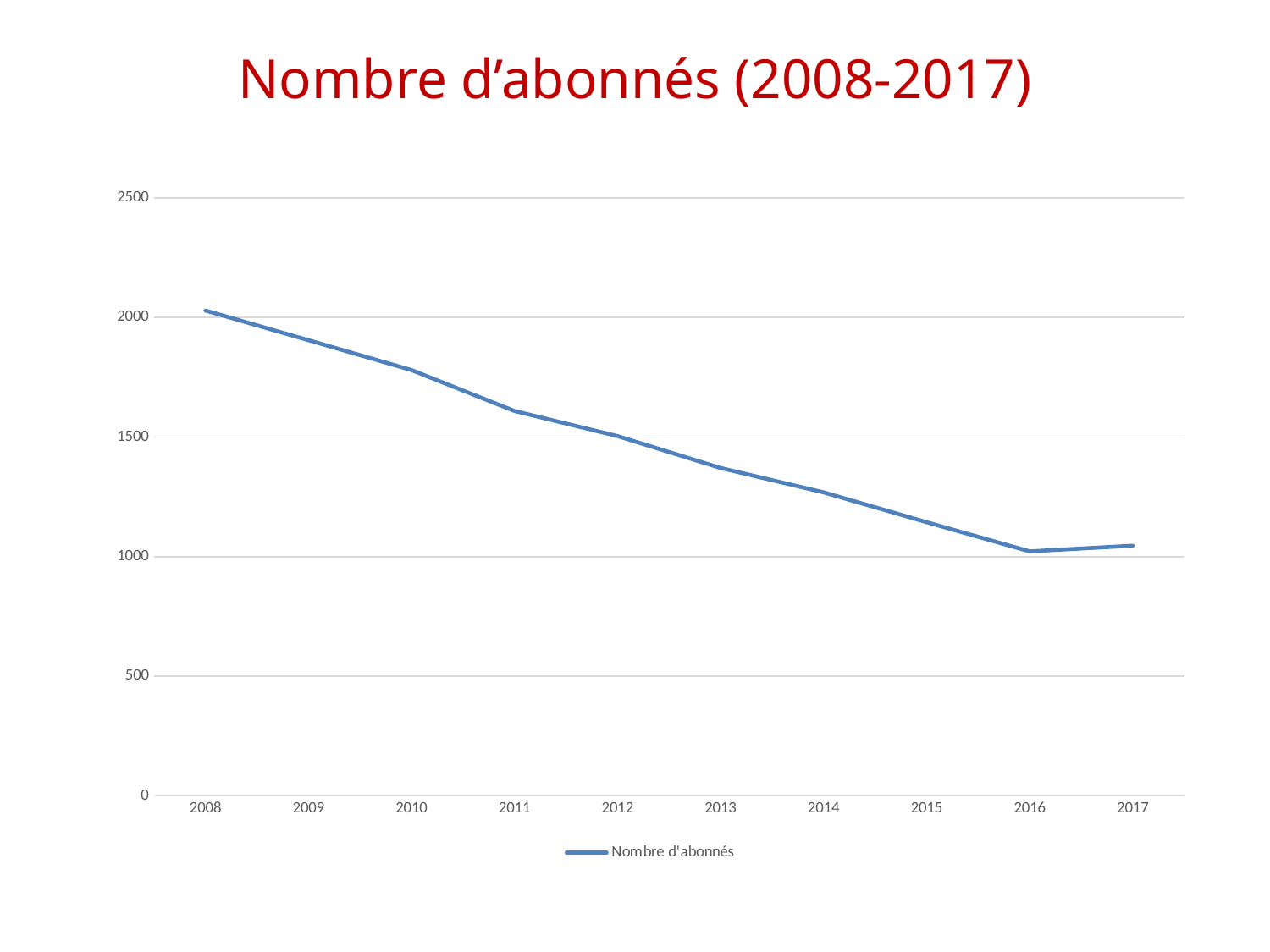
Which year has the highest number of subscribers? 2008 Is the value for 2015 greater or less than 1000? greater Is the value for 2011 greater or less than 1500? greater Is the value for 2013 greater or less than 1500? less How many series does the legend list? 1 What kind of chart is shown on the slide? line chart How many years are plotted along the x axis? 10 What is the title of the chart? Nombre d’abonnés (2008-2017) Do the values generally rise or fall from 2008 to 2017? fall Which year has the larger value, 2009 or 2014? 2009 What is the name of the series shown in the legend? Nombre d'abonnés